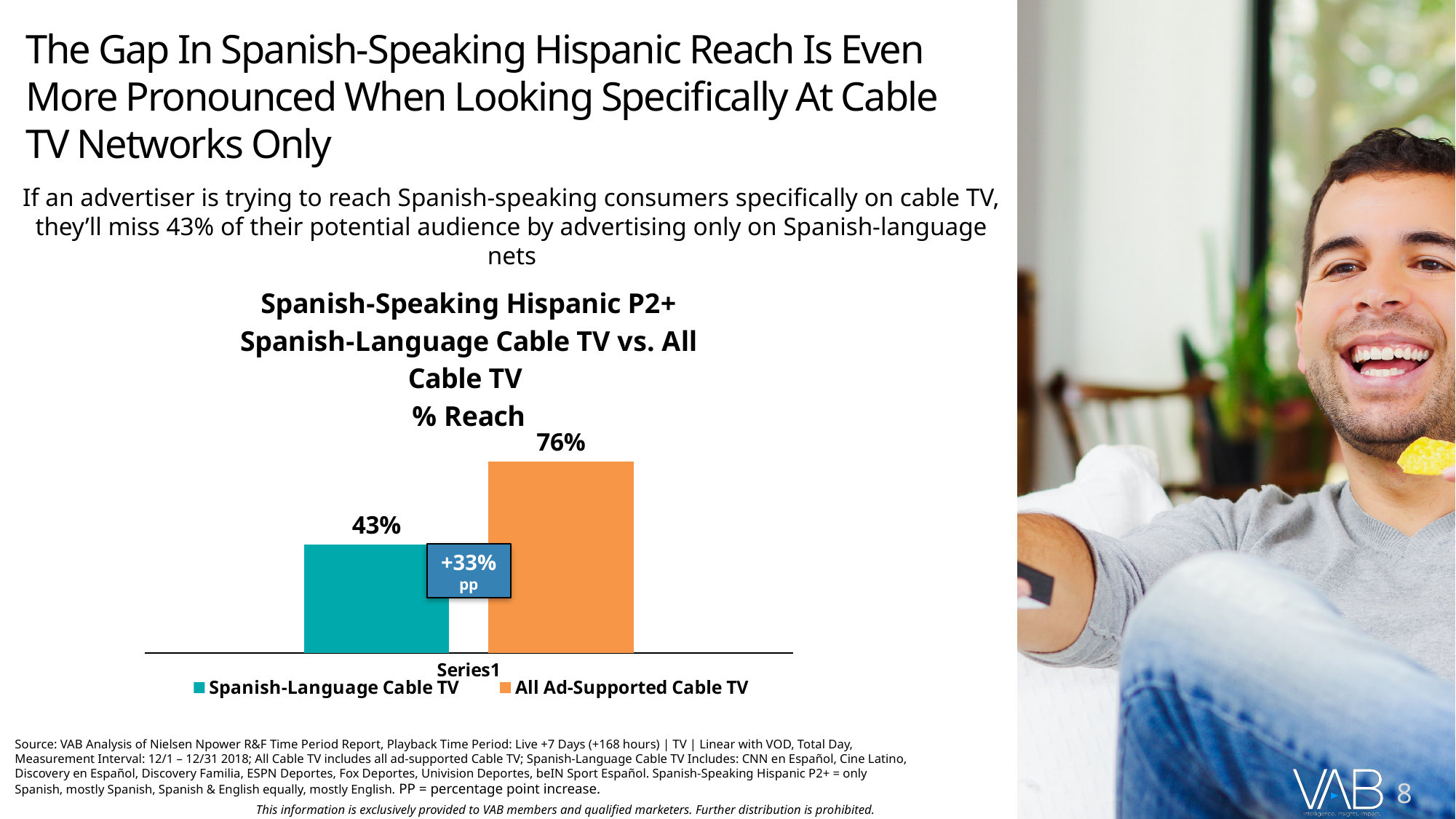
How many series does the legend list? 2 Which series has the highest % reach? All Ad-Supported Cable TV Which series has the higher % reach, Spanish-Language Cable TV or All Ad-Supported Cable TV? All Ad-Supported Cable TV What is the % reach for Spanish-Language Cable TV? 43% What percentage point increase is shown in the callout box between the two bars? +33% pp What is the % reach for All Ad-Supported Cable TV? 76% What kind of chart is shown on the slide? Bar chart What is the difference in % reach between All Ad-Supported Cable TV and Spanish-Language Cable TV? 33% How many bars are plotted in the chart? 2 What colour is the bar for All Ad-Supported Cable TV? Orange Which series has the lowest % reach? Spanish-Language Cable TV